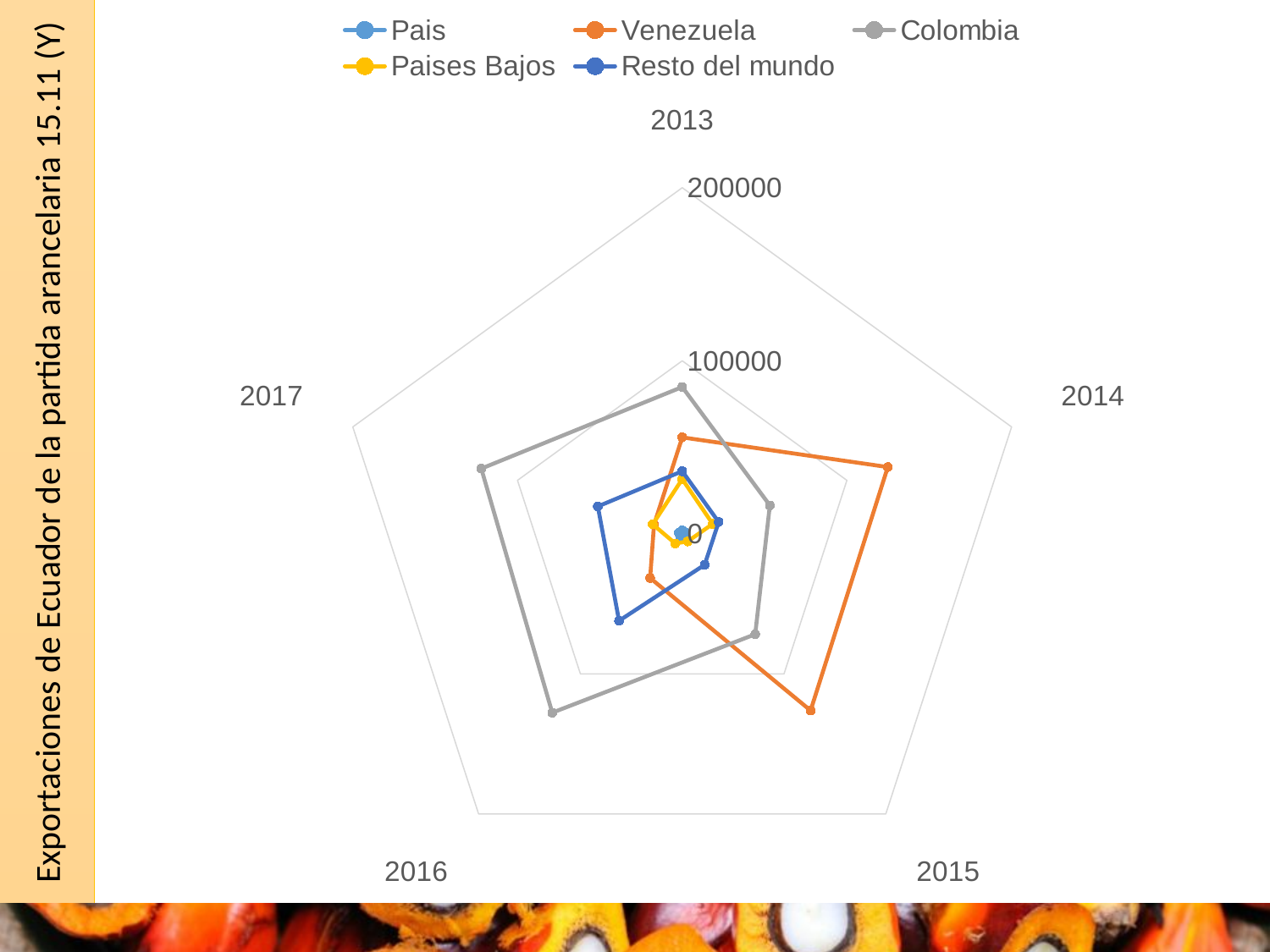
Is the value for Colombia in 2014 greater or less than 100000? less Is the value for Colombia in 2016 greater or less than 100000? greater Is the value for Resto del mundo in 2017 greater or less than 100000? less How many year categories (axes) does the radar chart have? 5 Which series has the highest value in 2016? Colombia What is the title shown on the left side of the slide? Exportaciones de Ecuador de la partida arancelaria 15.11 (Y) Which series has the highest value in 2014? Venezuela How many series does the legend list? 5 In 2017, which is larger: the value for Colombia or the value for Venezuela? Colombia What kind of chart is shown on the slide? Radar chart